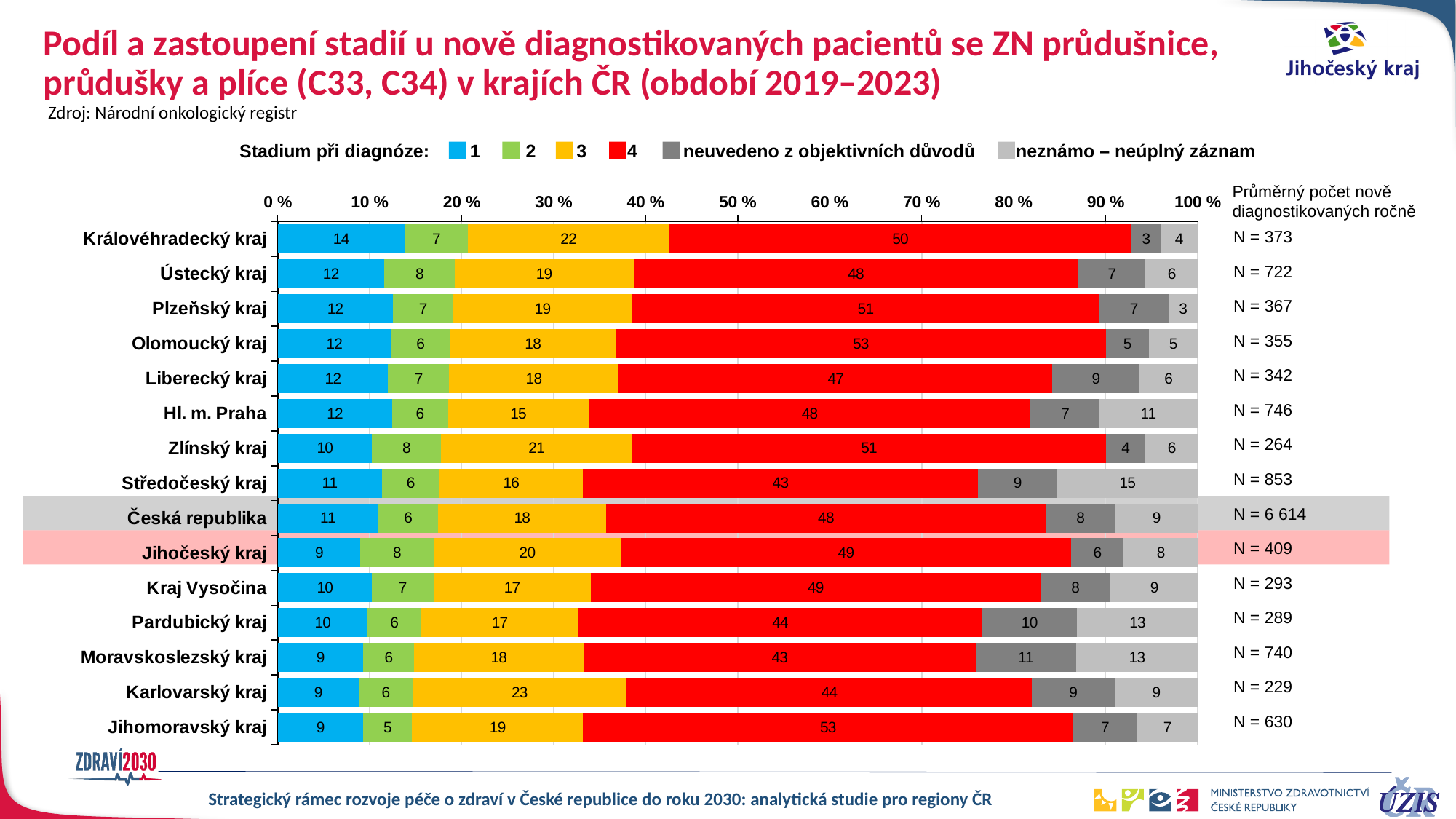
What is the average annual number of newly diagnosed patients (N) shown for Jihočeský kraj? N = 409 Which is larger: the stage 1 value for Královéhradecký kraj or the stage 1 value for Jihomoravský kraj? Královéhradecký kraj What is the value for stage 4 in Jihočeský kraj? 49 What is the difference between the stage 3 value for Karlovarský kraj and the stage 3 value for Hl. m. Praha? 8 What is the value for stage 1 in Královéhradecký kraj? 14 Which region has the highest value for stage 3? Karlovarský kraj What kind of chart is shown on the slide? Stacked bar chart Which region has the highest value for stage 1? Královéhradecký kraj What is the value for 'neznámo – neúplný záznam' in Středočeský kraj? 15 How many regions (categories) are plotted in the chart? 15 How many series does the legend 'Stadium při diagnóze' list? 6 Which region has the lowest value for stage 2? Jihomoravský kraj